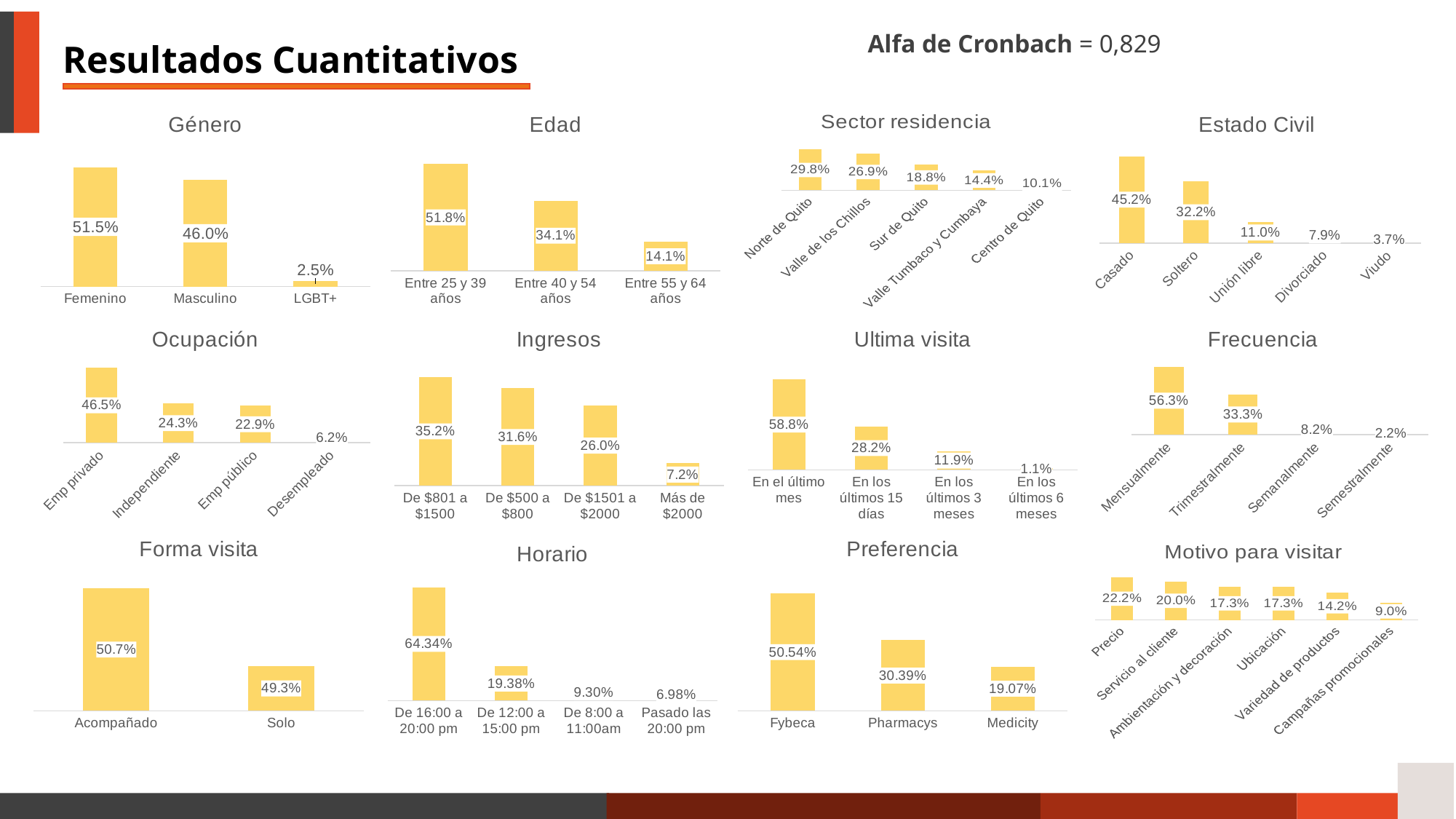
In the 'Ultima visita' chart, what is the value for 'En los últimos 15 días'? 28.2% In the 'Horario' chart, what is the value for 'De 16:00 a 20:00 pm'? 64.34% In the 'Ingresos' chart, how many income categories are shown? 4 In the 'Preferencia' chart, what is the value for Medicity? 19.07% In the 'Ocupación' chart, which category has the lowest value? Desempleado In the 'Edad' chart, which age group has the highest value? Entre 25 y 39 años In the 'Sector residencia' chart, what is the value for Centro de Quito? 10.1% In the 'Género' chart, what is the value for Femenino? 51.5% In the 'Forma visita' chart, what is the difference between Acompañado and Solo? 1.4% In the 'Estado Civil' chart, what is the difference between Casado and Soltero? 13.0% In the 'Frecuencia' chart, which is larger: Trimestralmente or Semanalmente? Trimestralmente What kind of chart is the 'Motivo para visitar' chart? Bar chart